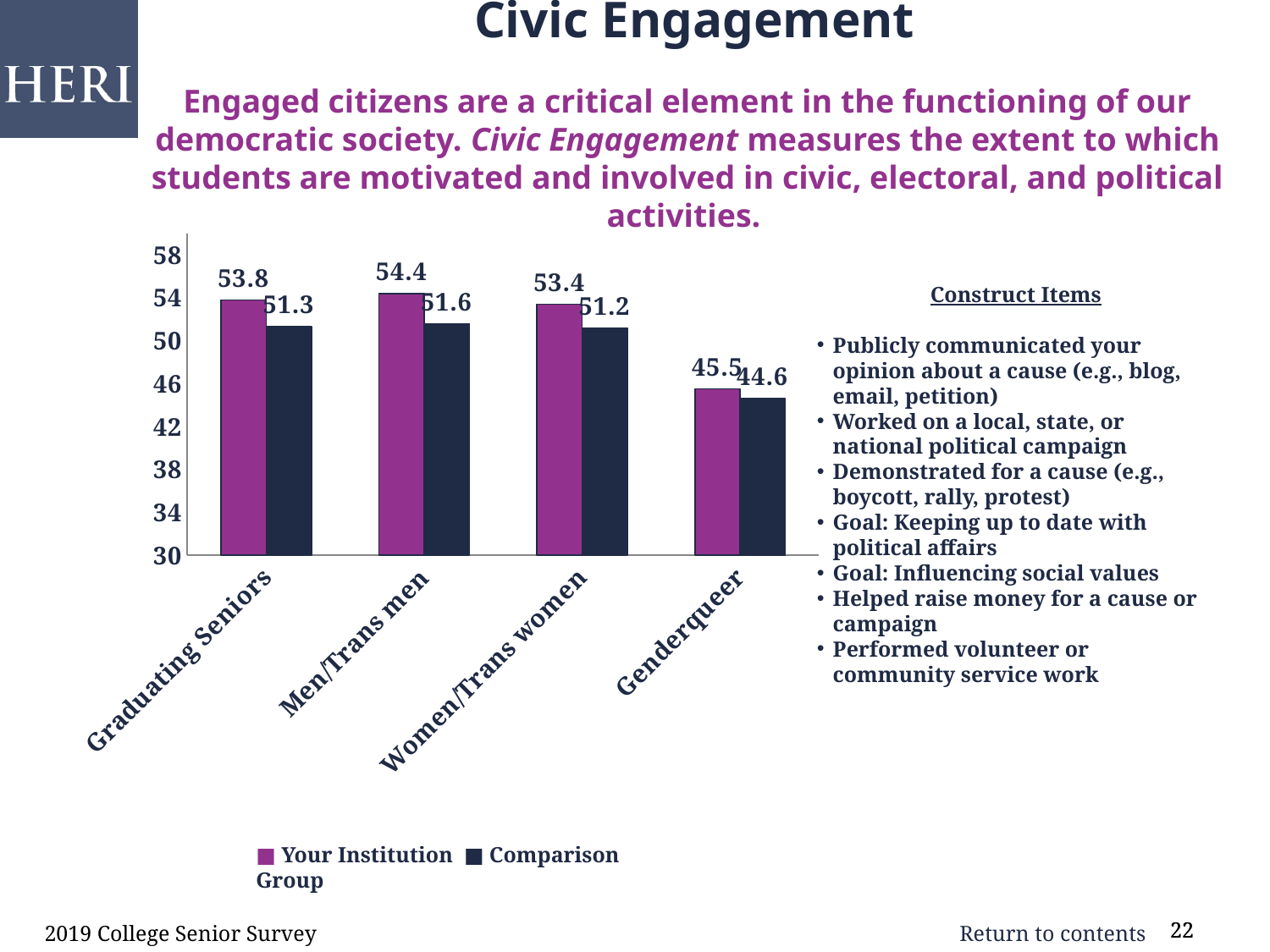
Which category has the highest Your Institution value? Men/Trans men What is the Your Institution value for Genderqueer? 45.5 What is the Your Institution value for Graduating Seniors? 53.8 How many series does the legend list? 2 What is the Comparison Group value for Women/Trans women? 51.2 Is the Comparison Group value for Genderqueer greater or less than 46? less What is the difference between the Your Institution and Comparison Group values for Graduating Seniors? 2.5 What kind of chart is shown on the slide? bar chart What is the Comparison Group value for Men/Trans men? 51.6 Which category has the lowest Comparison Group value? Genderqueer How many categories are shown on the x axis? 4 Which is larger for Men/Trans men: the Your Institution value or the Comparison Group value? Your Institution